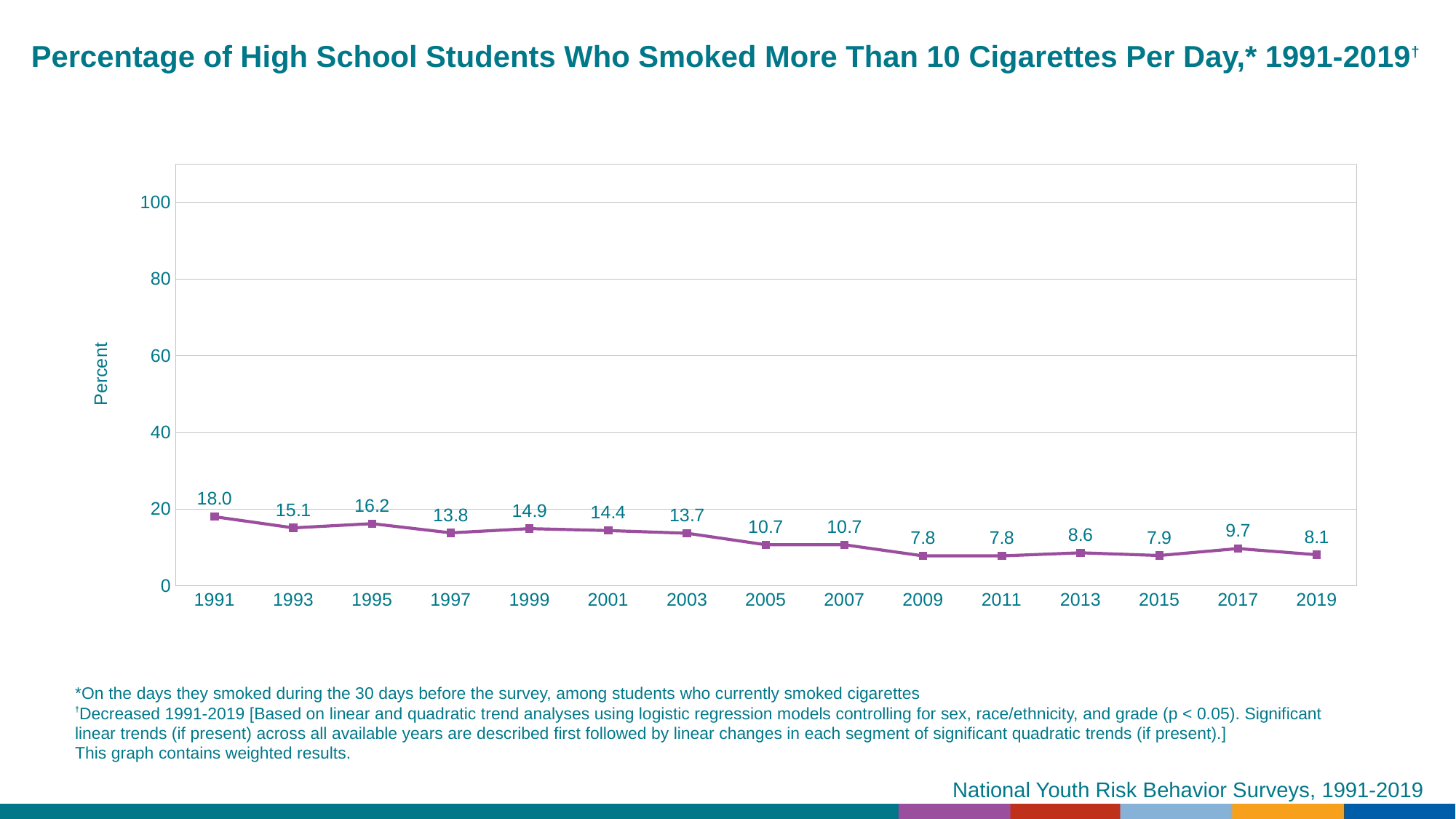
What is the value for 2005? 10.7 Which is larger, the value for 1995 or the value for 1997? 1995 Which year has the highest value? 1991 What is the lowest value shown on the chart? 7.8 What is the difference between the values for 1991 and 2019? 9.9 Is the value for 2013 greater or less than 20? less What is the value for 2019? 8.1 What is the value for 1991? 18.0 How many years are plotted on the chart? 15 What is the label on the y axis? Percent Do the values generally rise or fall from 1991 to 2019? fall What kind of chart is this? line chart